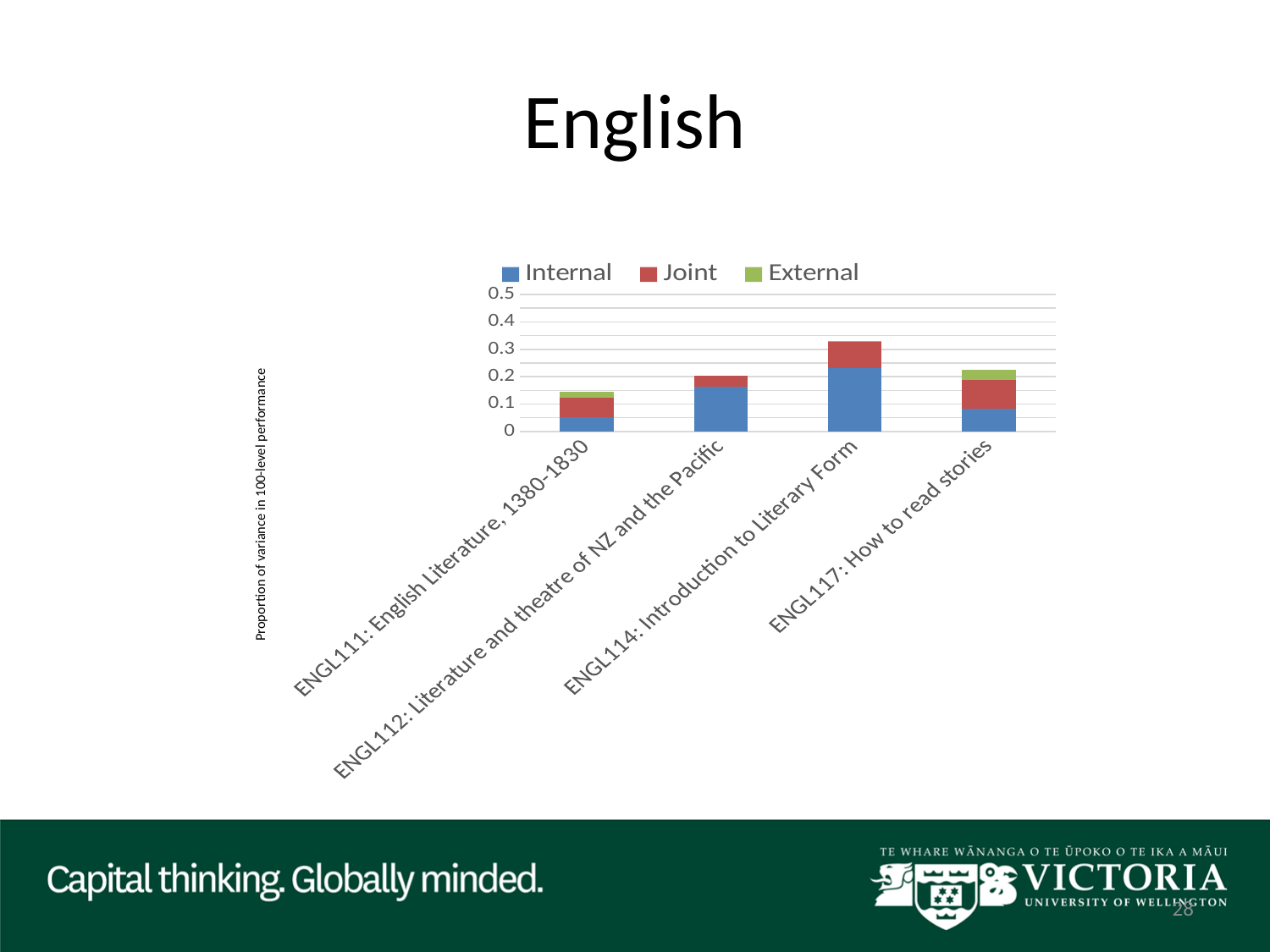
What is the label on the vertical axis of the chart? Proportion of variance in 100-level performance Which course has the smallest Internal segment? ENGL111: English Literature, 1380-1830 Is the total stacked value for ENGL114: Introduction to Literary Form greater or less than 0.3? greater What kind of chart is shown on the slide? Stacked bar chart Which course has the largest Internal segment? ENGL114: Introduction to Literary Form Is the total stacked value for ENGL111: English Literature, 1380-1830 greater or less than 0.2? less Which course has the tallest stacked bar overall? ENGL114: Introduction to Literary Form How many courses (categories) are plotted on the x axis? 4 Which has the larger Internal segment, ENGL112: Literature and theatre of NZ and the Pacific or ENGL117: How to read stories? ENGL112: Literature and theatre of NZ and the Pacific How many series does the legend list? 3 Is the Internal value for ENGL114: Introduction to Literary Form greater or less than 0.2? greater Which course has the shortest stacked bar overall? ENGL111: English Literature, 1380-1830